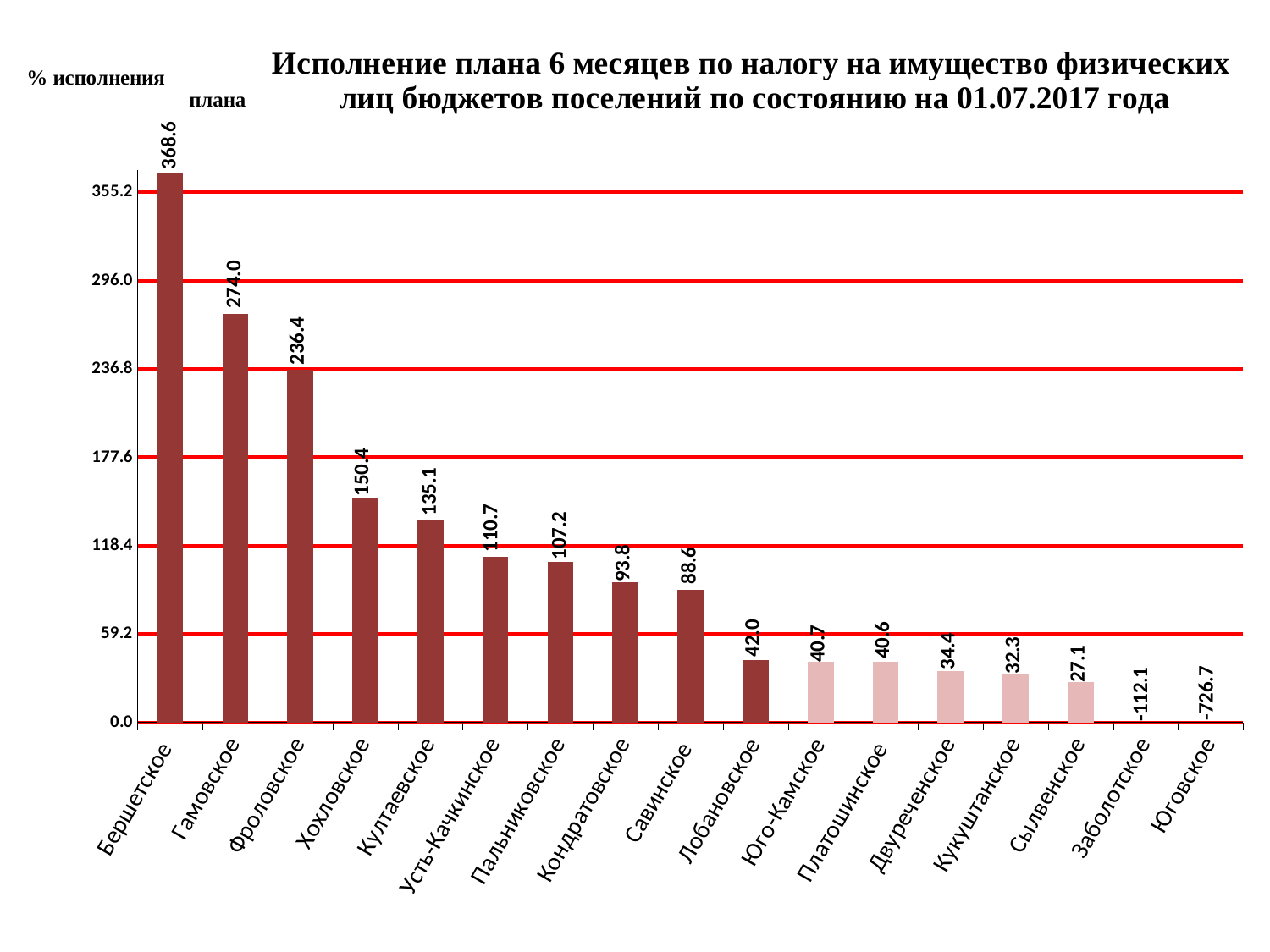
Which category has the highest value? Бершетское How many categories are shown on the x axis? 17 What is the value for Юговское? -726.7 Is the value for Кондратовское greater or less than 118.4? less What is the value for Хохловское? 150.4 What is the value for Бершетское? 368.6 What kind of chart is shown on the slide? bar chart Which is larger, the value for Култаевское or the value for Усть-Качкинское? Култаевское Which category has the lowest value? Юговское Do the values rise or fall from left to right along the x axis? fall What is the value for Сылвенское? 27.1 What is the difference between the values for Гамовское and Фроловское? 37.6